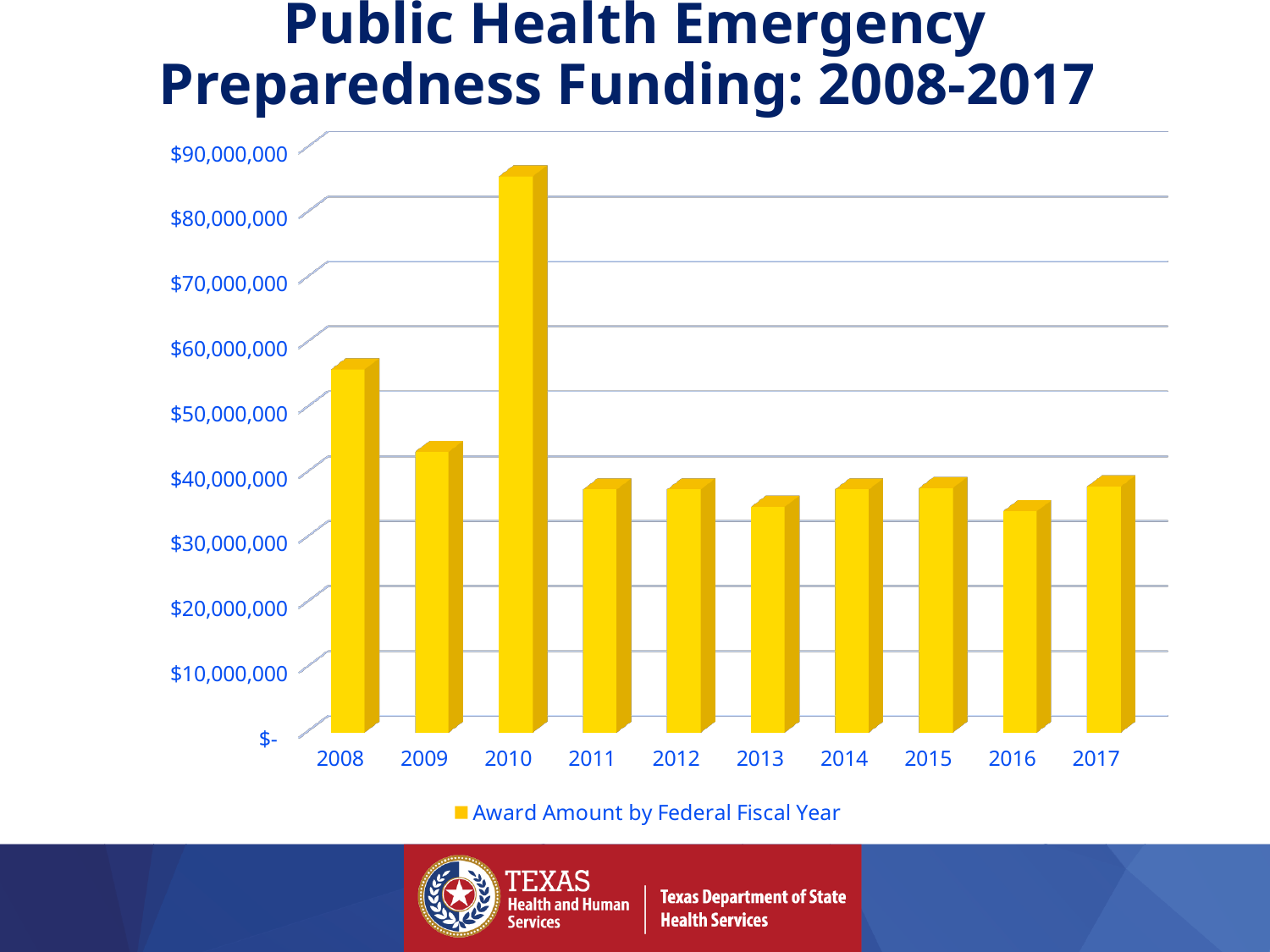
Is the value for 2010 greater or less than $80,000,000? greater Which year has the highest award amount? 2010 What kind of chart is shown on the slide? bar chart How many series does the legend list? 1 Is the value for 2013 greater or less than $40,000,000? less Do the values rise or fall from 2008 to 2009? fall What is the series name shown in the legend? Award Amount by Federal Fiscal Year How many years are shown on the x axis? 10 Which is larger, the value for 2008 or the value for 2009? 2008 Which is larger, the value for 2009 or the value for 2016? 2009 Is the value for 2009 greater or less than $40,000,000? greater